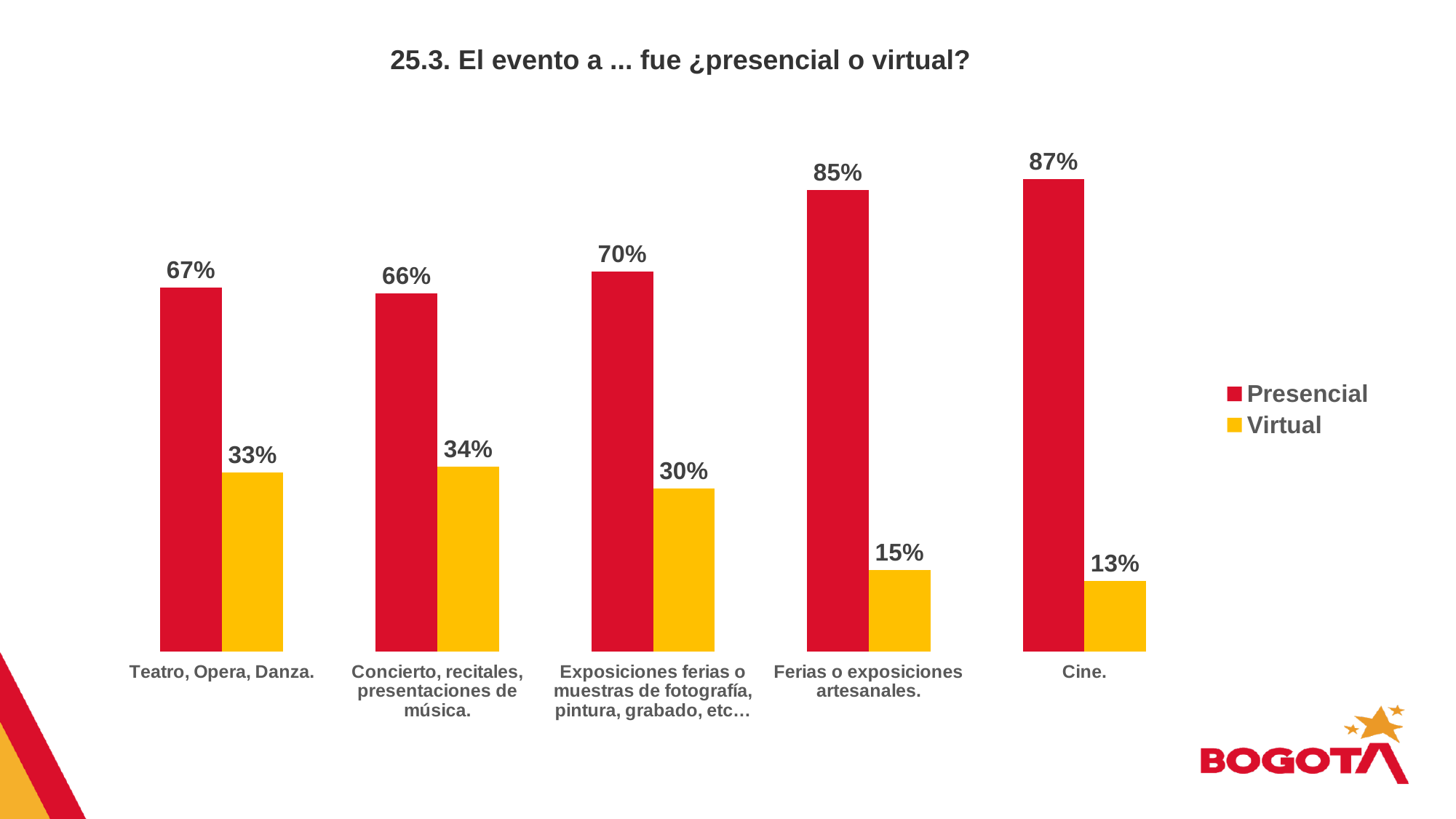
What kind of chart is shown on the slide? Bar chart How many categories are shown on the x axis? 5 Which category has the lowest Virtual value? Cine. What is the Presencial value for Cine.? 87% What is the Virtual value for Teatro, Opera, Danza.? 33% What is the Presencial value for Ferias o exposiciones artesanales.? 85% What is the Virtual value for Concierto, recitales, presentaciones de música.? 34% How many series does the legend list? 2 What is the difference between the Presencial and Virtual values for Exposiciones ferias o muestras de fotografía, pintura, grabado, etc…? 40% What colour are the Virtual bars? Yellow Which category has the highest Presencial value? Cine. Which is larger: the Virtual value for Ferias o exposiciones artesanales. or the Virtual value for Cine.? Ferias o exposiciones artesanales.